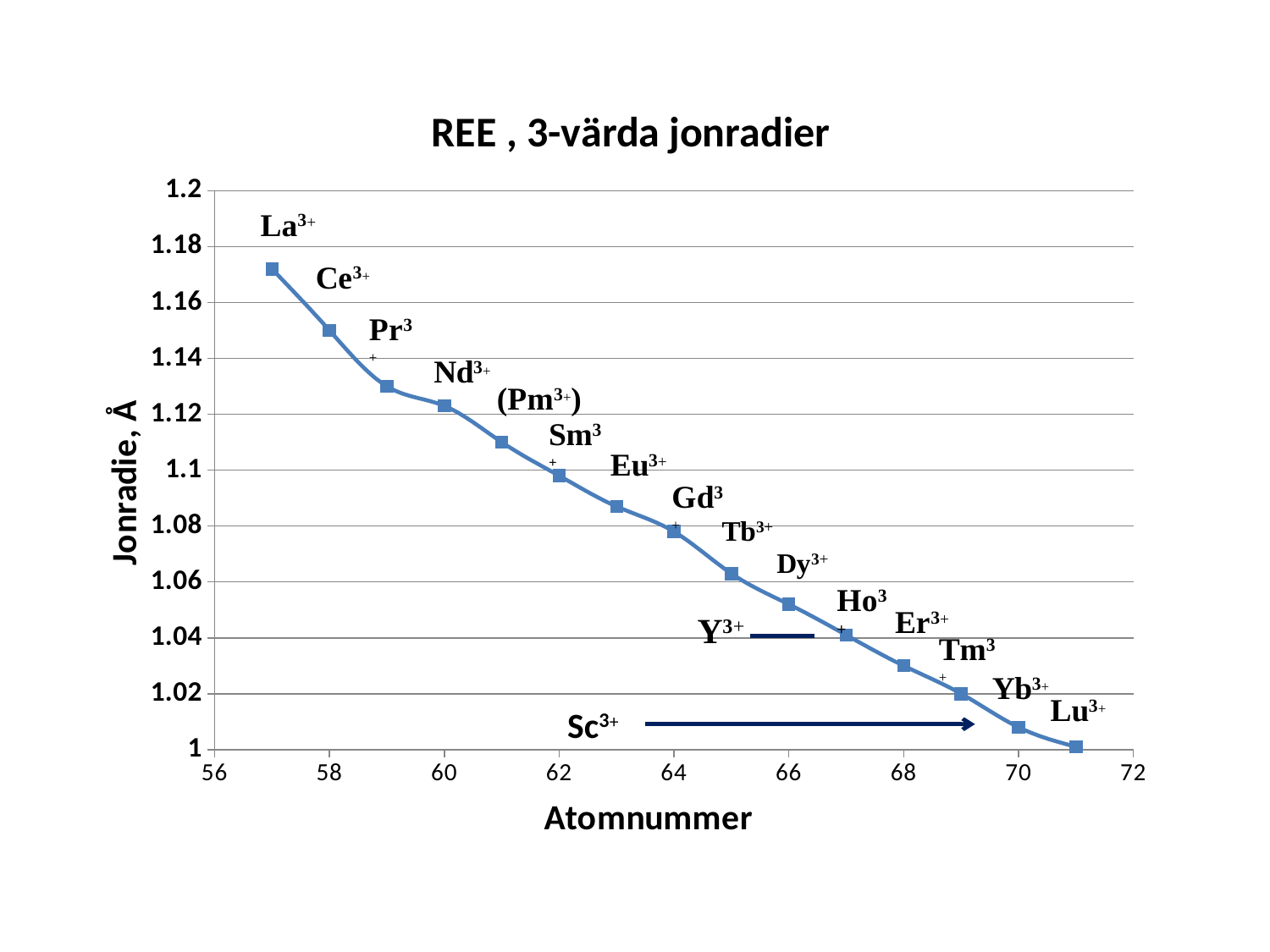
What is the title of the chart? REE , 3-värda jonradier Which has the larger ionic radius, Dy3+ or Er3+? Dy3+ Is the ionic radius for La3+ greater or less than 1.16? greater What is the label of the x axis? Atomnummer Which ion has the smallest ionic radius on the chart? Lu3+ Is the ionic radius for Yb3+ greater or less than 1.02? less What kind of chart is shown on the slide? line chart Which ion has the largest ionic radius on the chart? La3+ Is the ionic radius for Eu3+ greater or less than 1.1? less Do the ionic radius values rise or fall as the atomic number increases along the x axis? fall How many data points are plotted on the line? 15 Which has the larger ionic radius, Ce3+ or Nd3+? Ce3+